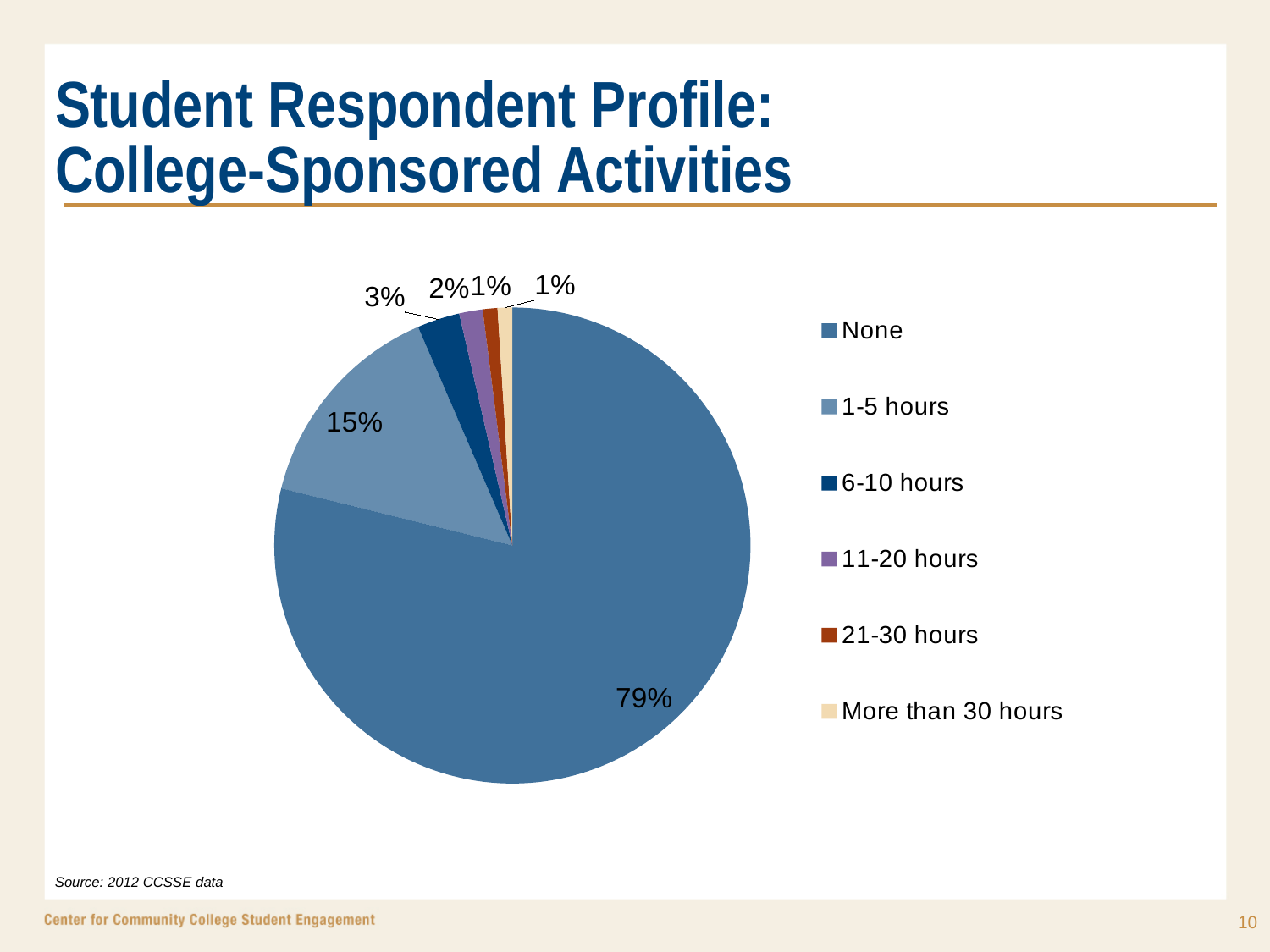
Which is larger, the share for 1-5 hours or the share for 6-10 hours? 1-5 hours What is the combined share of the 6-10 hours and 11-20 hours slices? 5% What share of respondents reported spending no hours on college-sponsored activities (None)? 79% What is the difference in percentage points between the None slice and the 1-5 hours slice? 64 What percentage of respondents spend more than 30 hours on college-sponsored activities? 1% What percentage of respondents spend 6-10 hours on college-sponsored activities? 3% What data source is cited for the chart? 2012 CCSSE data What percentage of respondents spend 11-20 hours on college-sponsored activities? 2% Which category has the largest share of the pie? None What type of chart is shown on the slide? Pie chart What percentage of respondents spend 1-5 hours on college-sponsored activities? 15% How many categories does the pie chart show? 6